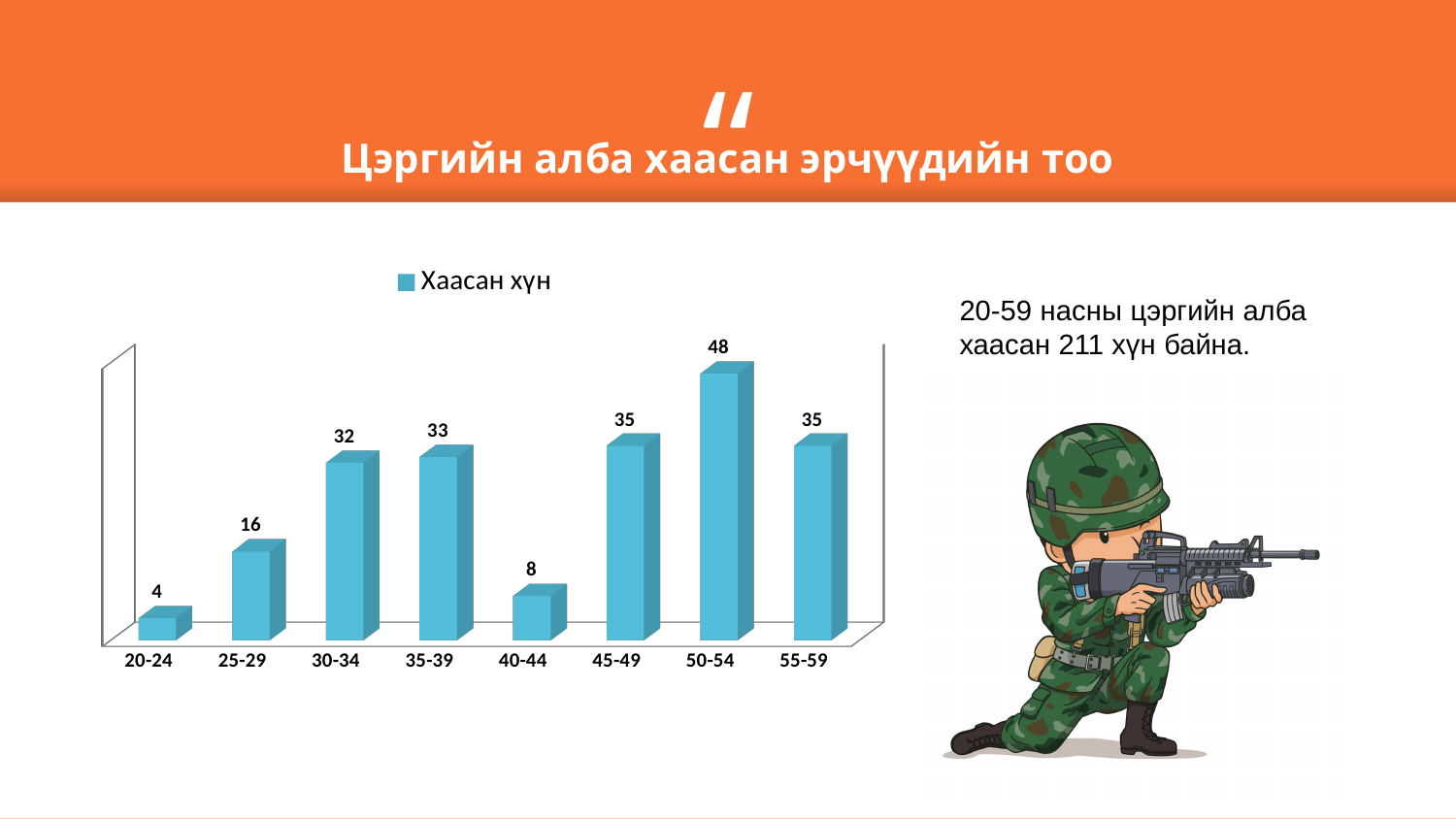
How many series does the legend list? 1 What is the difference between the values for 50-54 and 45-49? 13 What is the value for the 40-44 age group? 8 What kind of chart is shown on the slide? bar chart Which age group has the highest value? 50-54 How many age groups are shown on the x axis? 8 What is the difference between the values for 25-29 and 20-24? 12 Which age group has the lowest value? 20-24 What is the value for the 50-54 age group? 48 What is the legend entry for the series? Хаасан хүн What is the value for the 20-24 age group? 4 Which is larger, the value for 30-34 or the value for 35-39? 35-39